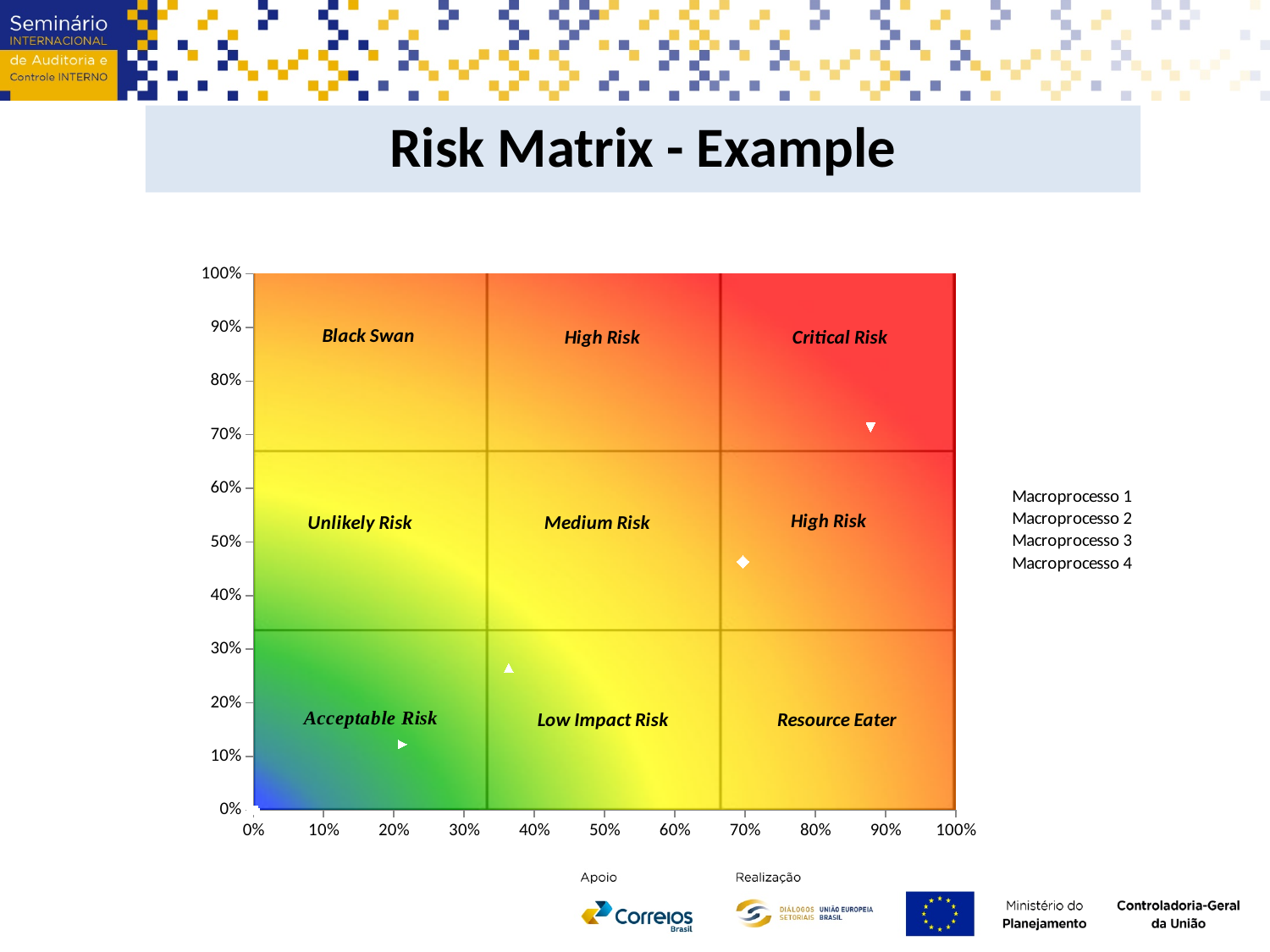
Is the horizontal (x-axis) value of the point in the Acceptable Risk zone greater or less than 30%? less How many series does the legend list? 4 What is the title of the slide containing the chart? Risk Matrix - Example What kind of chart is shown on the slide? scatter chart Which has the higher vertical (y-axis) value: the point in the Critical Risk zone or the point in the Acceptable Risk zone? the point in the Critical Risk zone Is the horizontal (x-axis) value of the point in the Critical Risk zone greater or less than 80%? greater Which risk zone label appears in the top-right cell of the matrix? Critical Risk Is the vertical (y-axis) value of the point in the Acceptable Risk zone greater or less than 20%? less How many data points are plotted on the risk matrix? 4